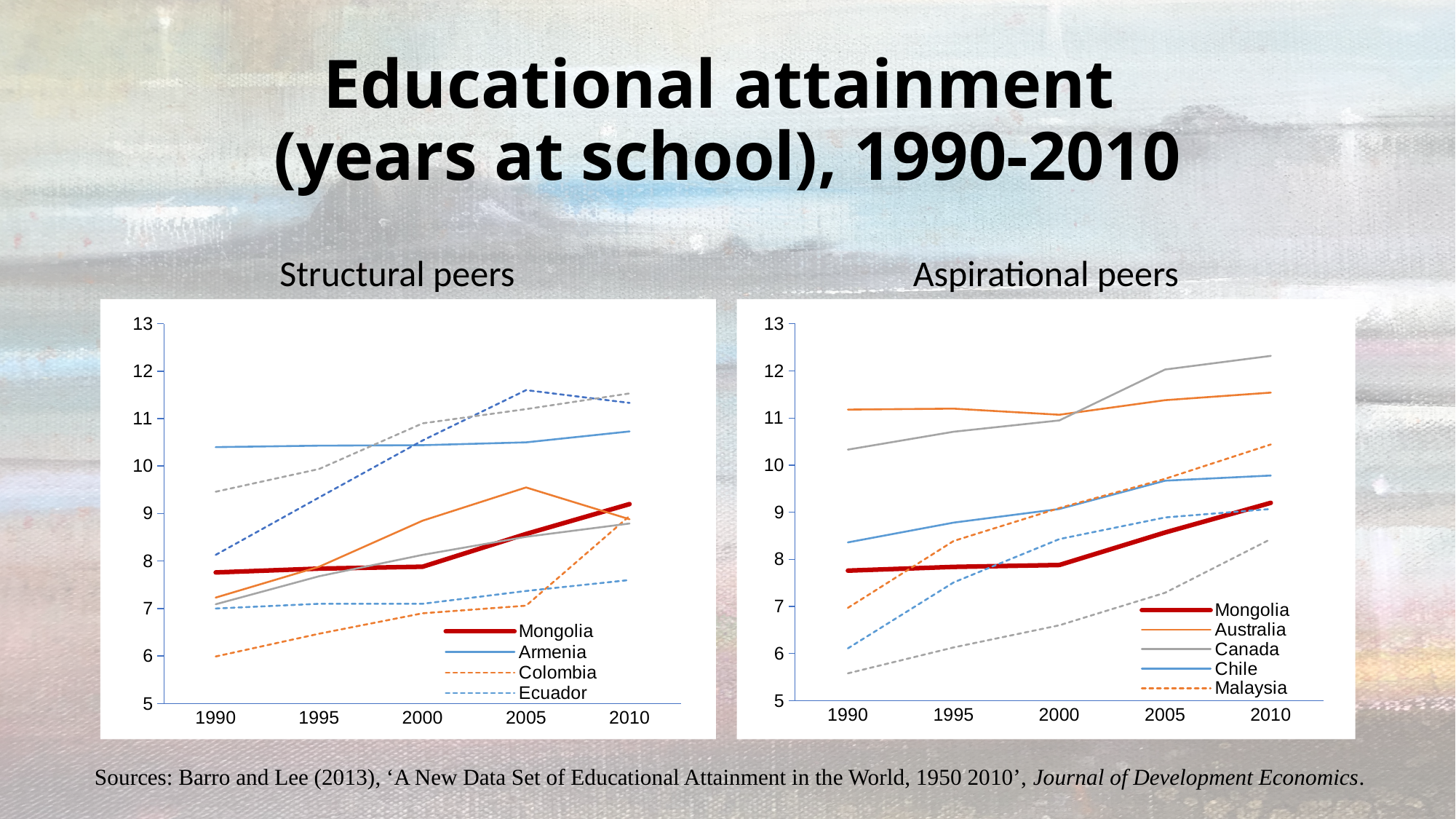
In the Aspirational peers chart, which of the legend series has the highest value in 2010? Canada In the Structural peers chart, is the value for Ecuador in 2005 greater or less than 11? less In the Structural peers chart, is the value for Armenia in 1990 greater or less than 10? greater How many years are marked on the x axis of the Aspirational peers chart? 5 In the Aspirational peers chart, does the value for Canada rise or fall from 1990 to 2010? rise How many series does the legend of the Structural peers chart list? 4 How many series does the legend of the Aspirational peers chart list? 5 In the Structural peers chart, which of the legend series has the lowest value in 1990? Colombia What kind of chart is the Structural peers chart? line chart In the Aspirational peers chart, is the value for Australia in 1990 greater or less than 11? greater